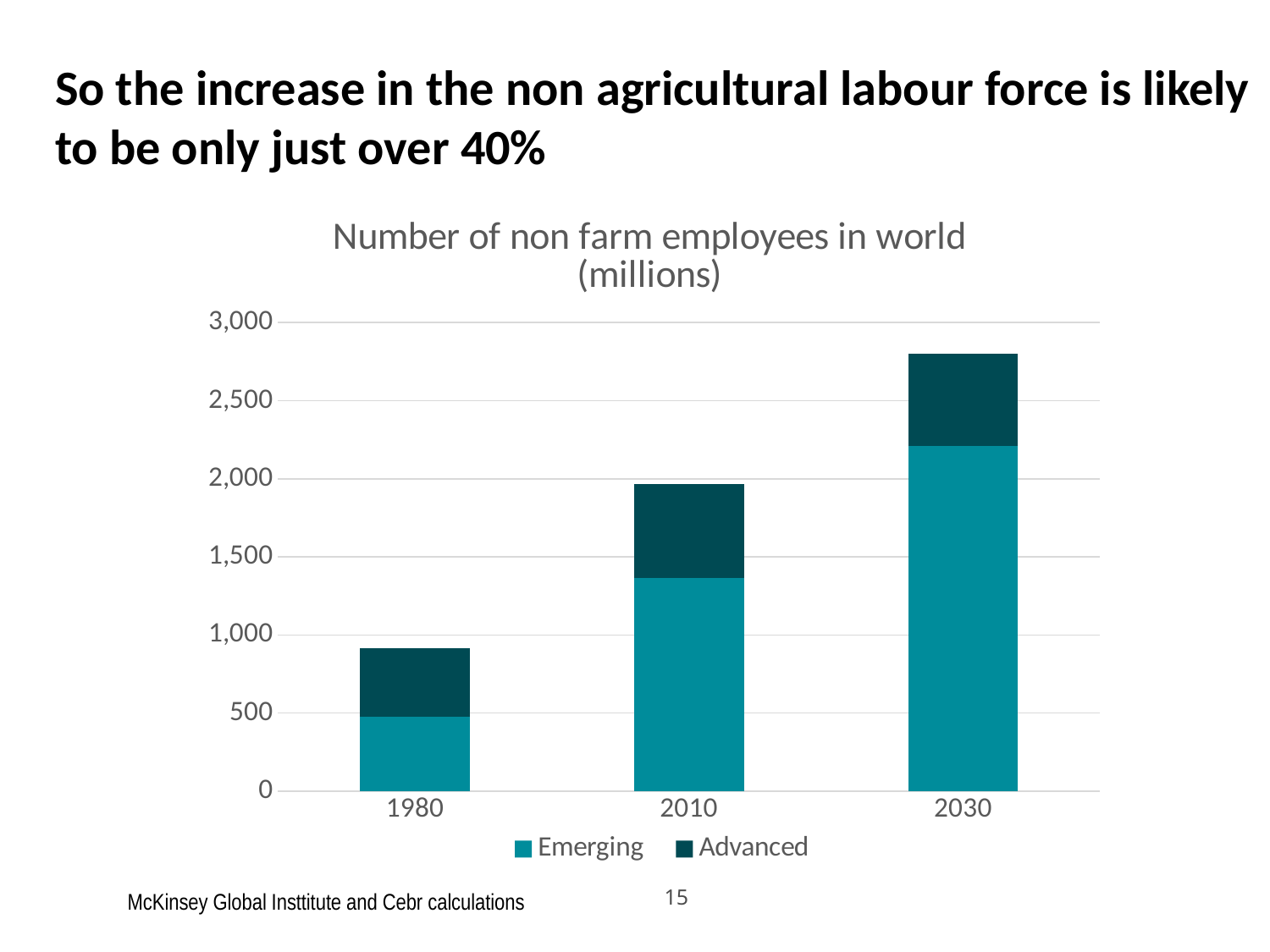
What is the title of the chart? Number of non farm employees in world (millions) How many years are shown on the x axis? 3 Which year has the lowest total number of non farm employees? 1980 Do the total values rise or fall from 1980 to 2030? Rise How many series does the legend list? 2 Which year has the highest total number of non farm employees? 2030 Is the Emerging value for 2010 greater or less than 1,000? greater Which two series are listed in the legend? Emerging and Advanced What kind of chart is shown on the slide? Stacked bar chart Is the total value for 2030 greater or less than 2,500? greater Is the total value for 1980 greater or less than 1,000? less In 2030, which is larger, the Emerging segment or the Advanced segment? Emerging